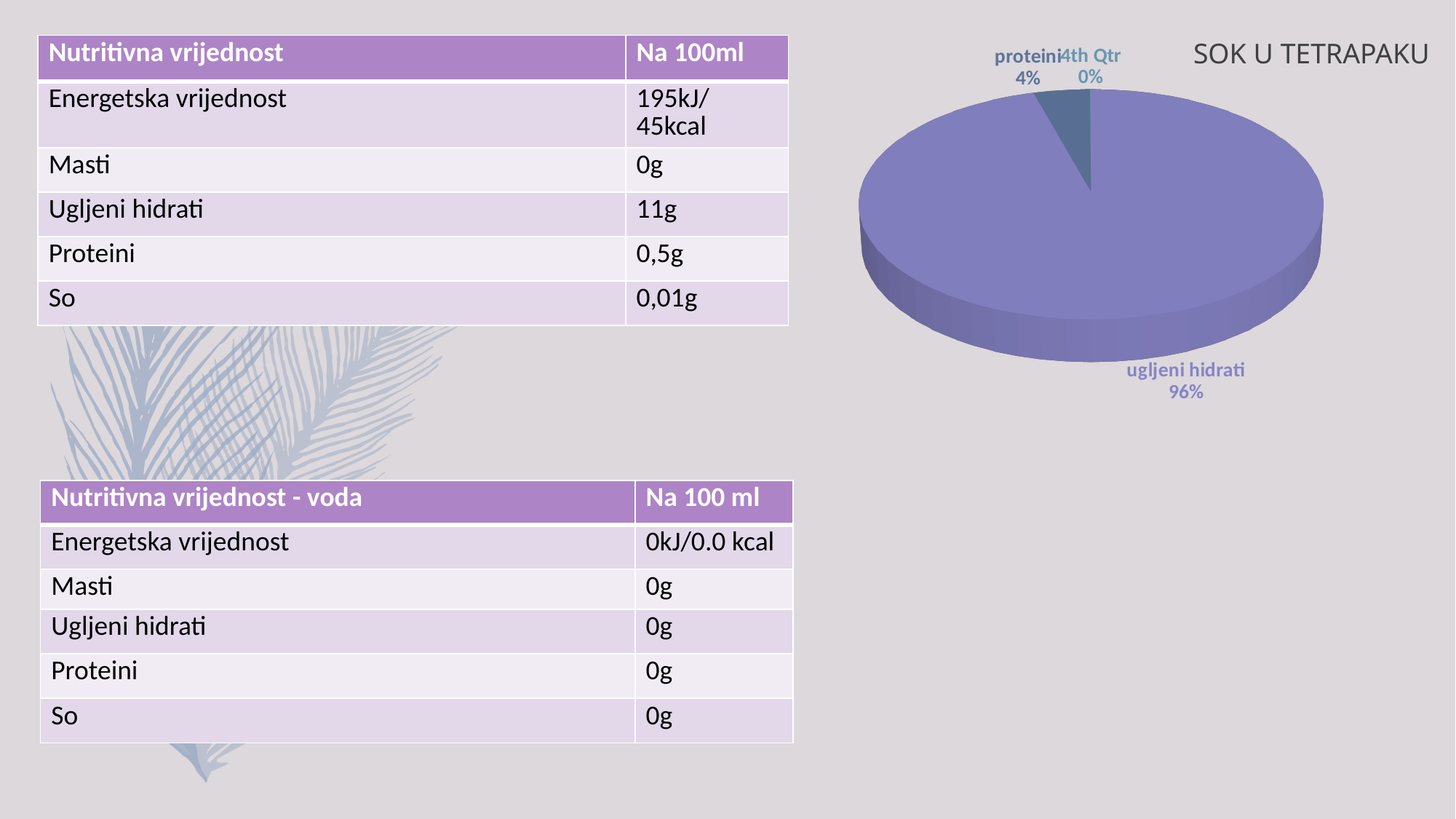
Which is larger in the pie chart, proteini or 4th Qtr? proteini What is the difference in percentage points between the ugljeni hidrati slice and the proteini slice? 92 What share of the pie chart does proteini have? 4% What is the title of the pie chart? SOK U TETRAPAKU What share of the pie chart does 4th Qtr have? 0% Which is larger in the pie chart, proteini or ugljeni hidrati? ugljeni hidrati Which slice of the pie chart is the largest? ugljeni hidrati What kind of chart is shown on the slide? pie chart What share of the pie chart does ugljeni hidrati have? 96% How many slices are labelled on the pie chart? 3 Which slice of the pie chart is the smallest? 4th Qtr